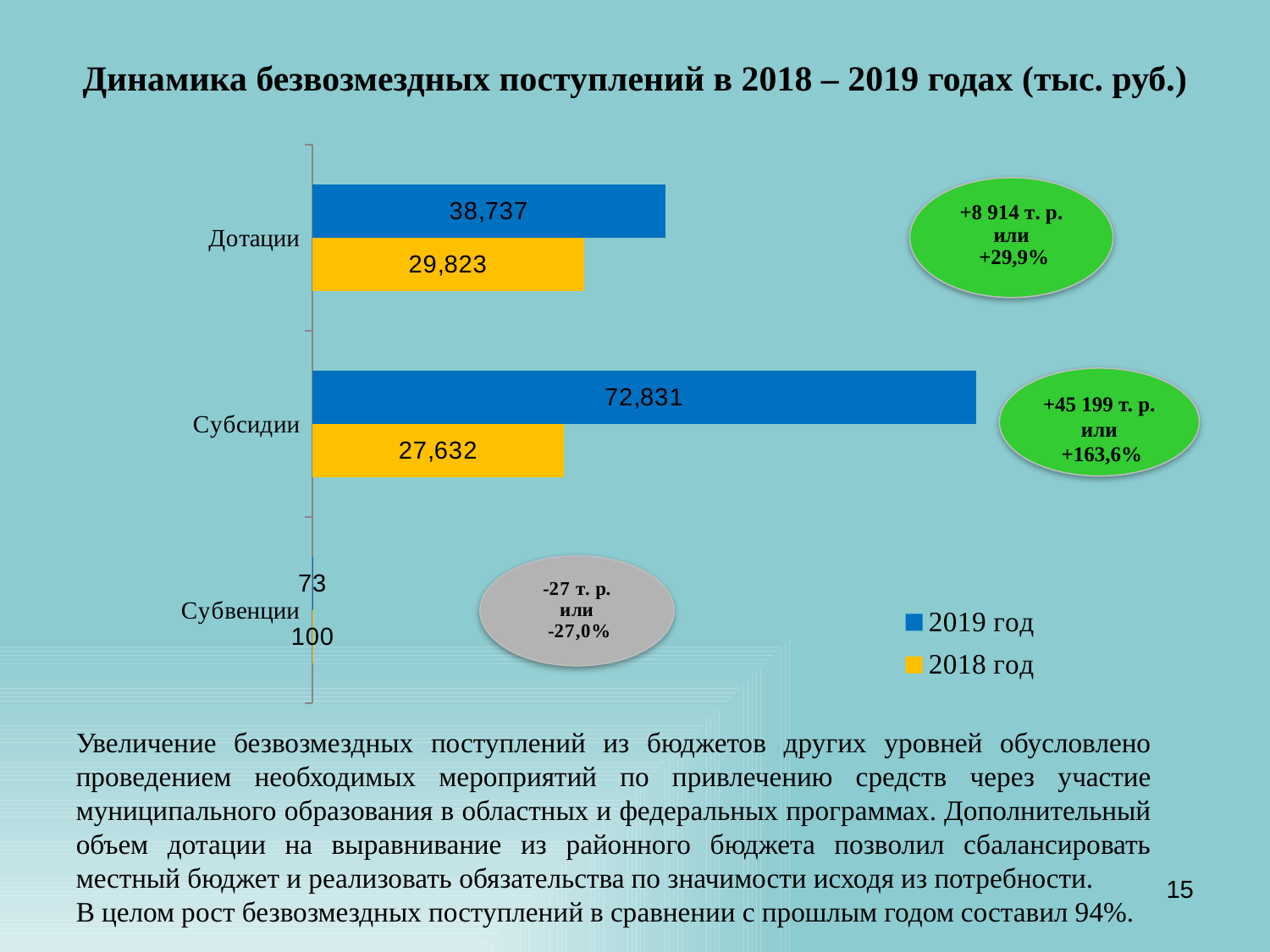
What is the difference between the 2019 год and 2018 год values for Дотации? 8,914 Which category has the highest value in the 2019 год series? Субсидии What is the value for Субсидии in the 2018 год series? 27,632 What kind of chart is shown on the slide? Bar chart What is the difference between the 2019 год and 2018 год values for Субсидии? 45,199 Which category has the lowest value in the 2018 год series? Субвенции What is the value for Дотации in the 2018 год series? 29,823 What is the value for Дотации in the 2019 год series? 38,737 What is the value for Субвенции in the 2019 год series? 73 For Субвенции, which series has the larger value, 2019 год or 2018 год? 2018 год How many series does the legend list? 2 How many categories are shown on the chart? 3